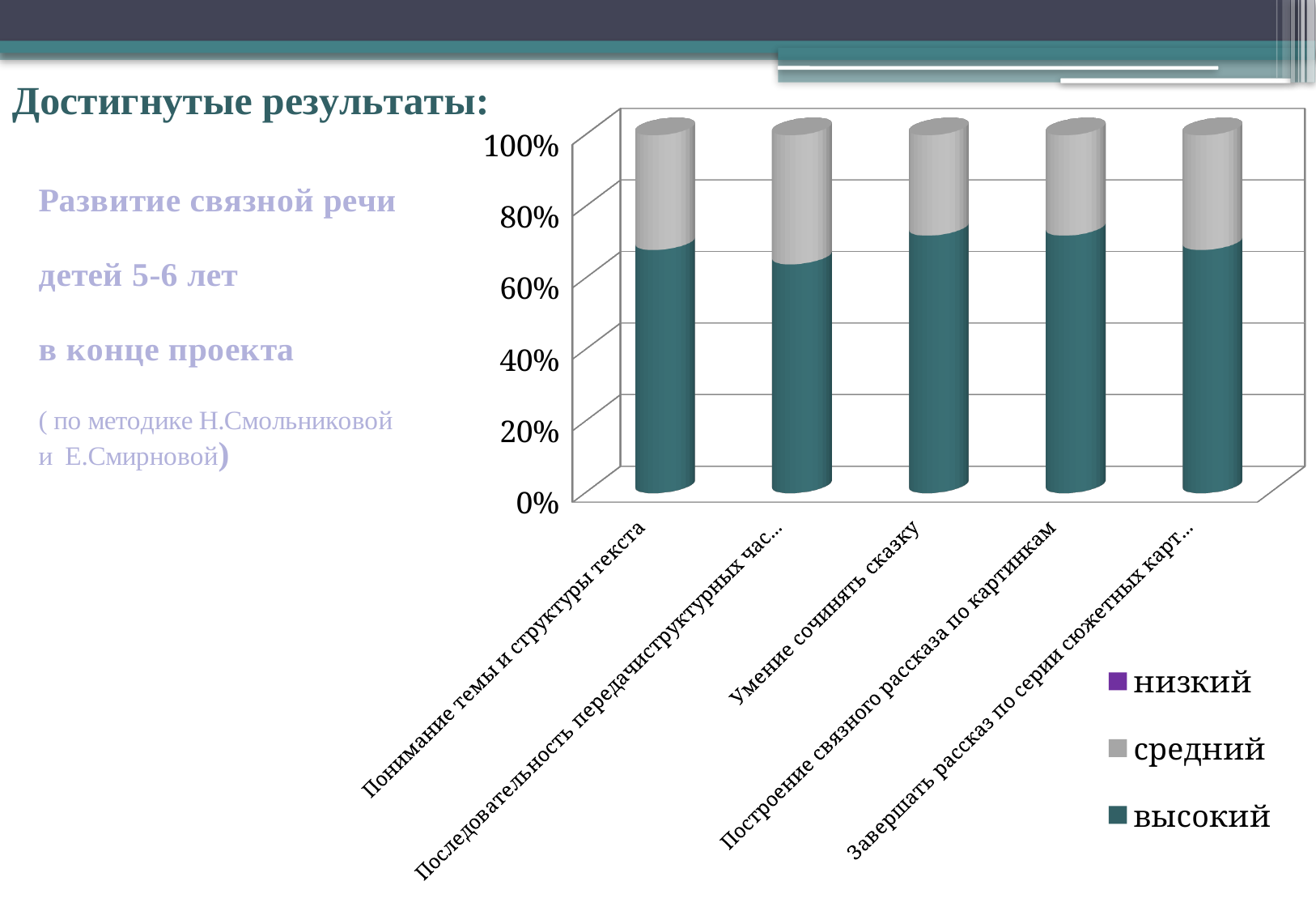
What are the three series named in the chart legend? низкий, средний, высокий Is the 'высокий' value for 'Умение сочинять сказку' greater or less than 60%? greater What total does each stacked bar reach on the percentage axis? 100% What kind of chart is shown on the slide? stacked bar chart Which category has the lowest 'высокий' value? Последовательность передачи структурных час... Which colour represents the series 'высокий' in the chart? dark teal Is the 'высокий' value for 'Последовательность передачи структурных час...' greater or less than 80%? less How many series does the chart legend list? 3 Which has a larger 'высокий' value: 'Умение сочинять сказку' or 'Последовательность передачи структурных час...'? Умение сочинять сказку Is the 'высокий' value for 'Понимание темы и структуры текста' greater or less than 60%? greater Which category has the largest 'средний' segment? Последовательность передачи структурных час... How many categories are plotted along the x axis of the chart? 5